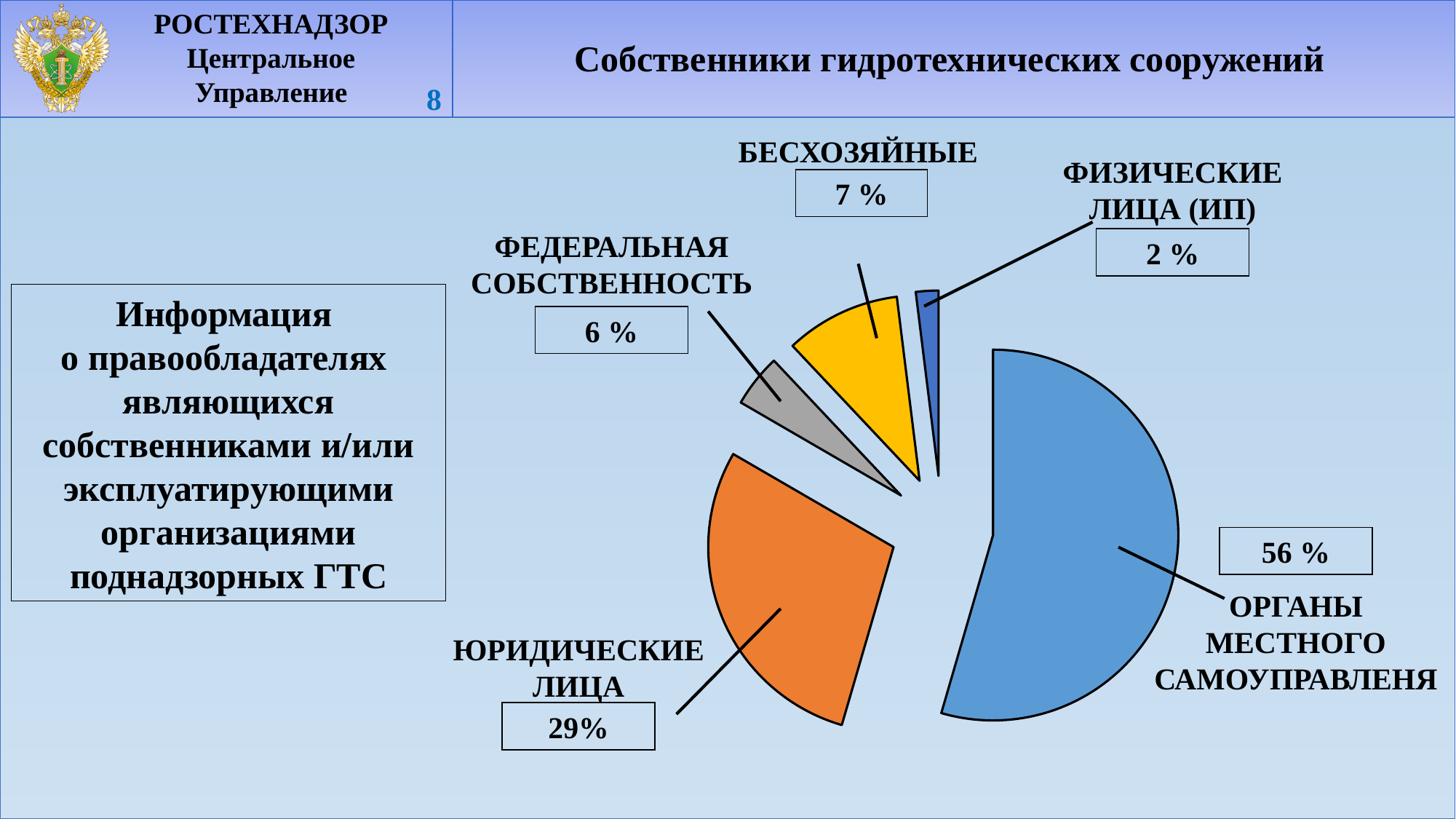
What share of the pie chart is labelled for ЮРИДИЧЕСКИЕ ЛИЦА? 29% What colour is the slice for ЮРИДИЧЕСКИЕ ЛИЦА? orange Which is larger, the share for БЕСХОЗЯЙНЫЕ or the share for ФЕДЕРАЛЬНАЯ СОБСТВЕННОСТЬ? БЕСХОЗЯЙНЫЕ Which category has the smallest slice of the pie chart? ФИЗИЧЕСКИЕ ЛИЦА (ИП) What kind of chart is shown on the slide? pie chart Which category has the largest slice of the pie chart? ОРГАНЫ МЕСТНОГО САМОУПРАВЛЕНЯ What share of the pie chart is labelled for ФЕДЕРАЛЬНАЯ СОБСТВЕННОСТЬ? 6 % What share of the pie chart is labelled for БЕСХОЗЯЙНЫЕ? 7 % What is the difference in percentage points between ОРГАНЫ МЕСТНОГО САМОУПРАВЛЕНЯ and ЮРИДИЧЕСКИЕ ЛИЦА? 27 What share of the pie chart is labelled for ОРГАНЫ МЕСТНОГО САМОУПРАВЛЕНЯ? 56 % What share of the pie chart is labelled for ФИЗИЧЕСКИЕ ЛИЦА (ИП)? 2 % How many slices does the pie chart have? 5